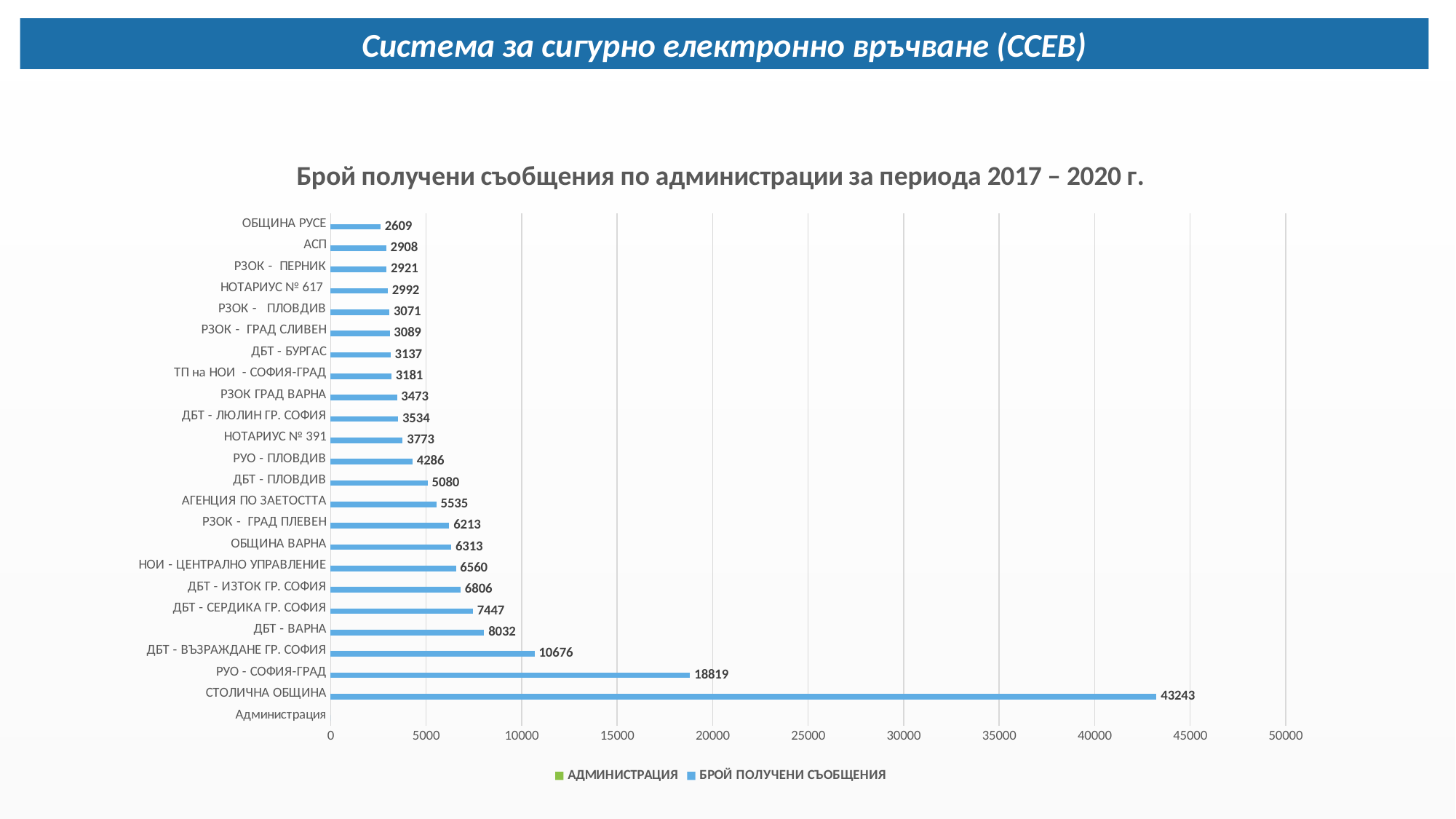
What type of chart is shown on the slide? bar chart Which administration has the lowest number of received messages? ОБЩИНА РУСЕ What is the title of the chart? Брой получени съобщения по администрации за периода 2017 – 2020 г. What is the difference between the values for СТОЛИЧНА ОБЩИНА and РУО - СОФИЯ-ГРАД? 24424 What is the value for РУО - СОФИЯ-ГРАД? 18819 How many series does the legend list? 2 Which is larger, the value for ОБЩИНА ВАРНА or the value for АГЕНЦИЯ ПО ЗАЕТОСТТА? ОБЩИНА ВАРНА What is the value for ДБТ - ВАРНА? 8032 What is the value for НОТАРИУС № 391? 3773 What is the difference between the values for ДБТ - ВАРНА and ДБТ - СЕРДИКА ГР. СОФИЯ? 585 Which administration has the highest number of received messages? СТОЛИЧНА ОБЩИНА What is the value for СТОЛИЧНА ОБЩИНА? 43243